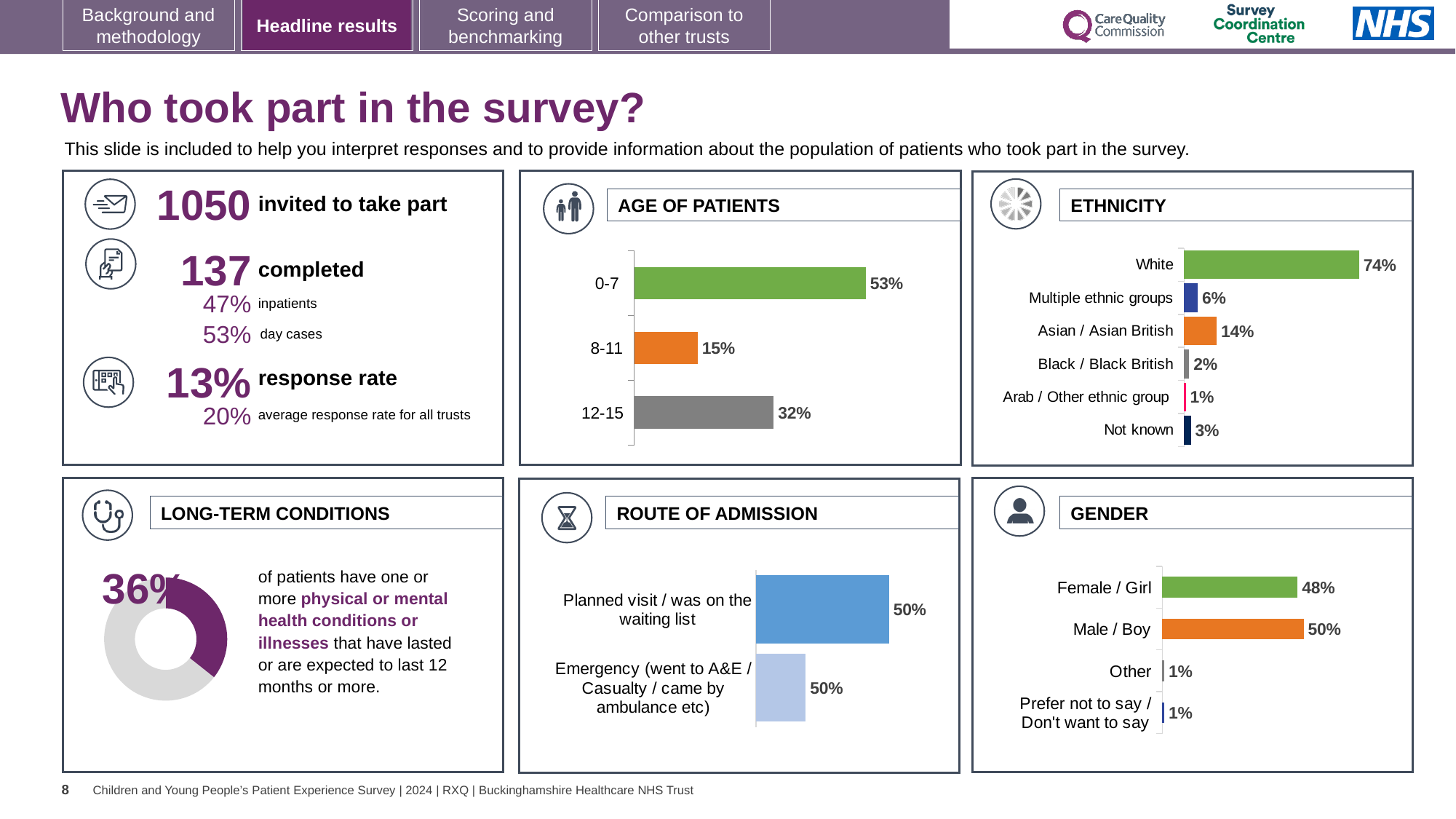
In the GENDER chart, how many gender categories are shown? 4 In the AGE OF PATIENTS chart, how many age groups are shown? 3 In the ROUTE OF ADMISSION chart, what percentage of patients had a planned visit / were on the waiting list? 50% In the LONG-TERM CONDITIONS chart, what percentage of patients have one or more long-term physical or mental health conditions? 36% In the AGE OF PATIENTS chart, which age group has the lowest percentage? 8-11 In the ETHNICITY chart, what is the difference between the percentages for Asian / Asian British and Multiple ethnic groups? 8 percentage points In the AGE OF PATIENTS chart, what percentage of patients are aged 0-7? 53% In the ETHNICITY chart, which category has the lowest percentage? Arab / Other ethnic group What kind of chart is the ROUTE OF ADMISSION chart? Bar chart In the ETHNICITY chart, how many ethnicity categories are shown? 6 In the ETHNICITY chart, what percentage of patients are White? 74% In the GENDER chart, what percentage of patients are Male / Boy? 50%